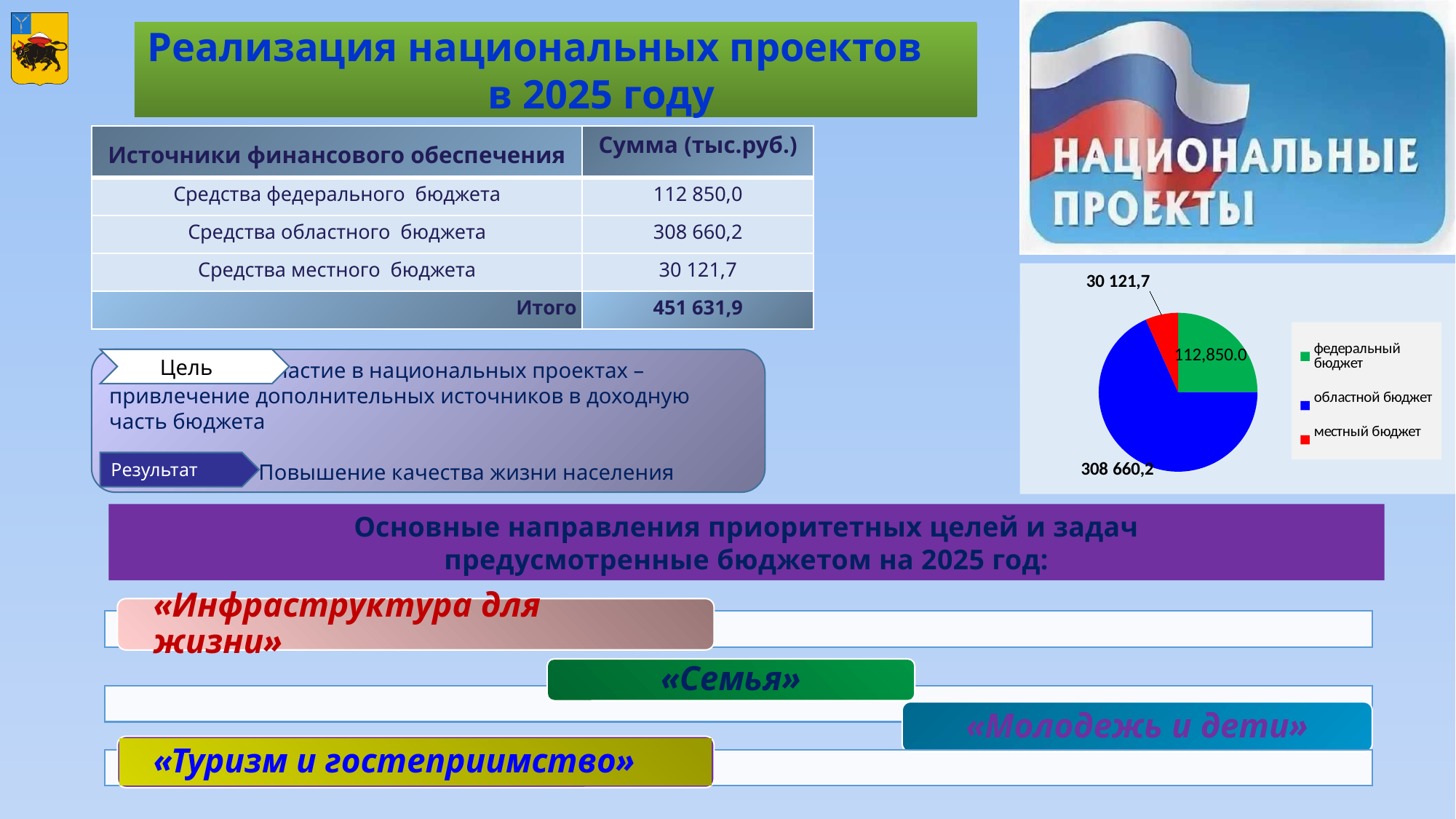
Which slice of the pie chart is the smallest? местный бюджет What colour is the областной бюджет slice in the pie chart? blue How many slices does the pie chart have? 3 How many entries does the pie chart's legend list? 3 What value is labelled on the pie chart for местный бюджет? 30 121,7 What value is labelled on the pie chart for областной бюджет? 308 660,2 What value is labelled on the pie chart for федеральный бюджет? 112,850.0 What is the difference between the федеральный бюджет and местный бюджет values in the pie chart? 82 728,3 What is the difference between the областной бюджет and федеральный бюджет values in the pie chart? 195 810,2 Which slice of the pie chart is the largest? областной бюджет Which is larger in the pie chart: федеральный бюджет or местный бюджет? федеральный бюджет What kind of chart is shown on the slide? pie chart